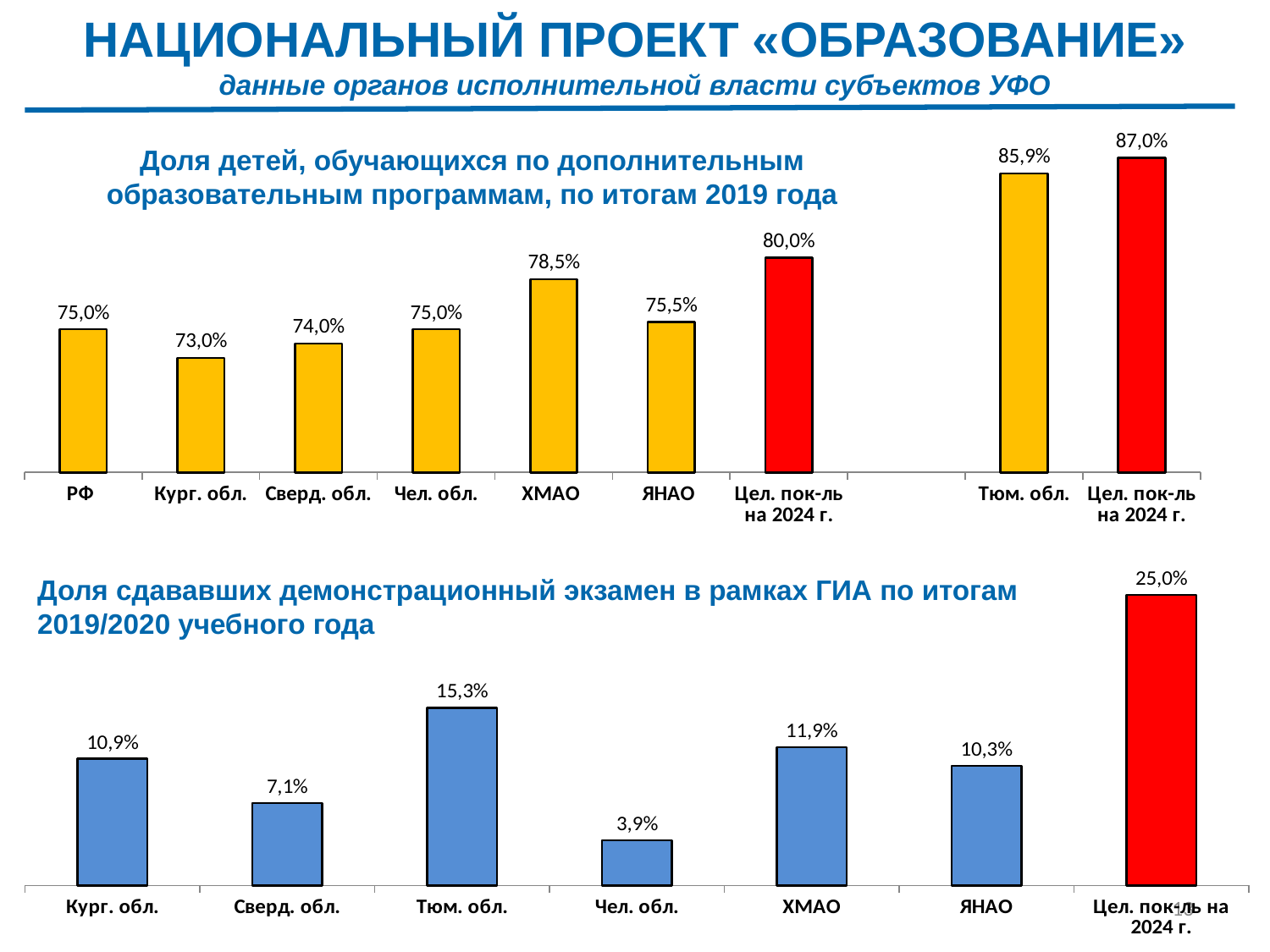
How many bars are plotted in the top chart? 9 In the top chart, which region among РФ, Кург. обл., Сверд. обл., Чел. обл., ХМАО, ЯНАО and Тюм. обл. has the lowest value? Кург. обл. In the bottom chart (share of students taking the demonstration exam within ГИА, 2019/2020), what is the value for Чел. обл.? 3,9% In the top chart, what is the difference between the value for ХМАО and the value for Кург. обл.? 5,5% What type of chart is the bottom chart? Bar chart In the bottom chart, which is larger: the value for ХМАО or the value for ЯНАО? ХМАО In the bottom chart, what colour is the bar for the 2024 target (Цел. пок-ль на 2024 г.)? Red In the top chart, which is larger: the value for ЯНАО or the value for Сверд. обл.? ЯНАО In the top chart (share of children in additional education programmes, 2019), what is the value for ХМАО? 78,5% In the top chart, what is the value for Тюм. обл.? 85,9% In the bottom chart, which region has the highest value, excluding the 2024 target bar? Тюм. обл. In the bottom chart, what is the difference between the 2024 target value and the value for Тюм. обл.? 9,7%